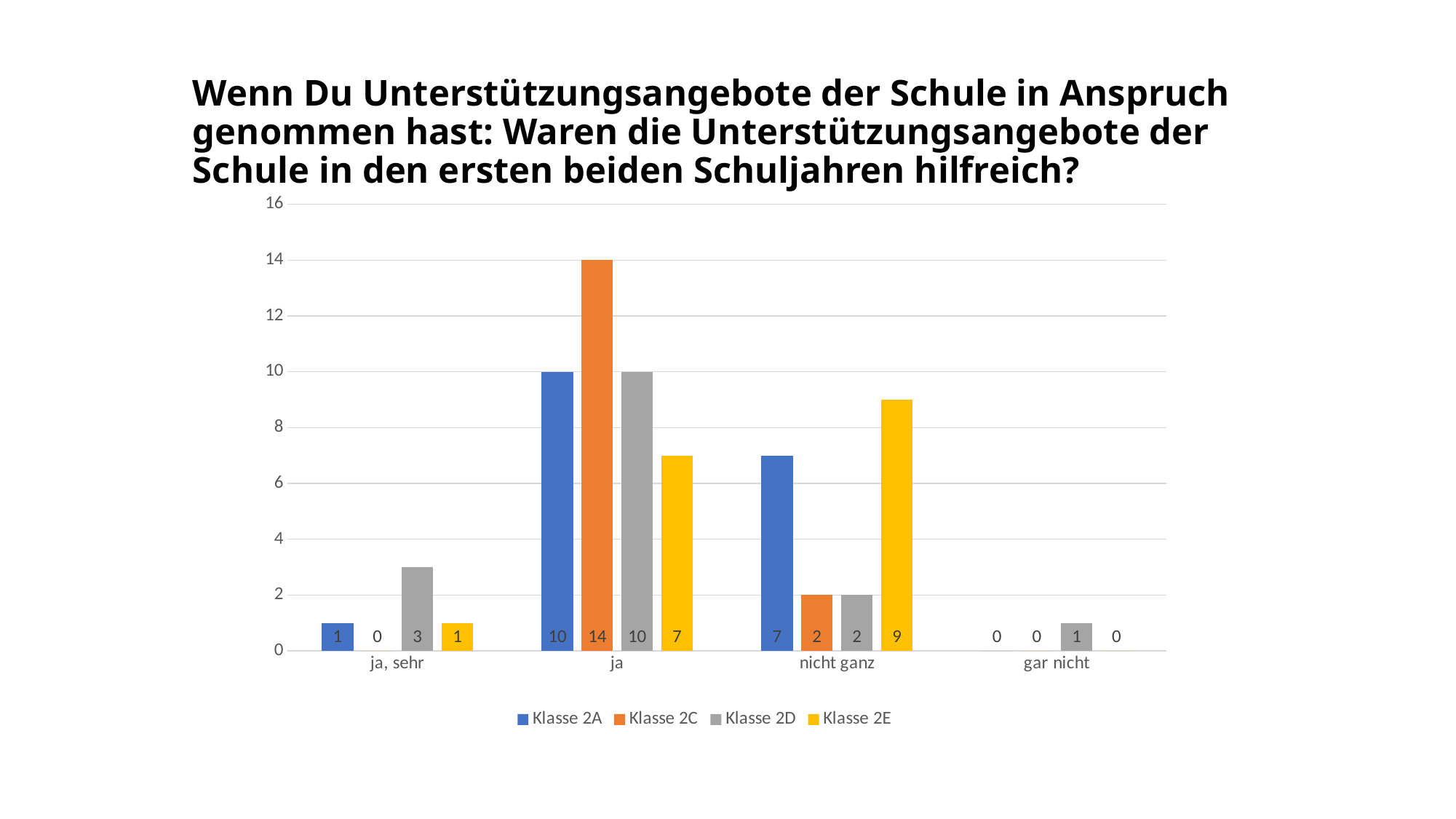
What is the difference between Klasse 2C and Klasse 2E in the "ja" category? 7 Is the value for Klasse 2C in the "ja" category greater or less than 12? greater What is the value for Klasse 2C in the "ja" category? 14 In the "nicht ganz" category, which is larger: Klasse 2A or Klasse 2E? Klasse 2E What is the value for Klasse 2D in the "ja, sehr" category? 3 Which series is shown in orange? Klasse 2C How many categories are shown on the x axis? 4 Which series has the highest value in the "ja" category? Klasse 2C What kind of chart is shown on the slide? bar chart What is the value for Klasse 2E in the "nicht ganz" category? 9 How many series does the legend list? 4 Which series has the lowest value in the "ja, sehr" category? Klasse 2C